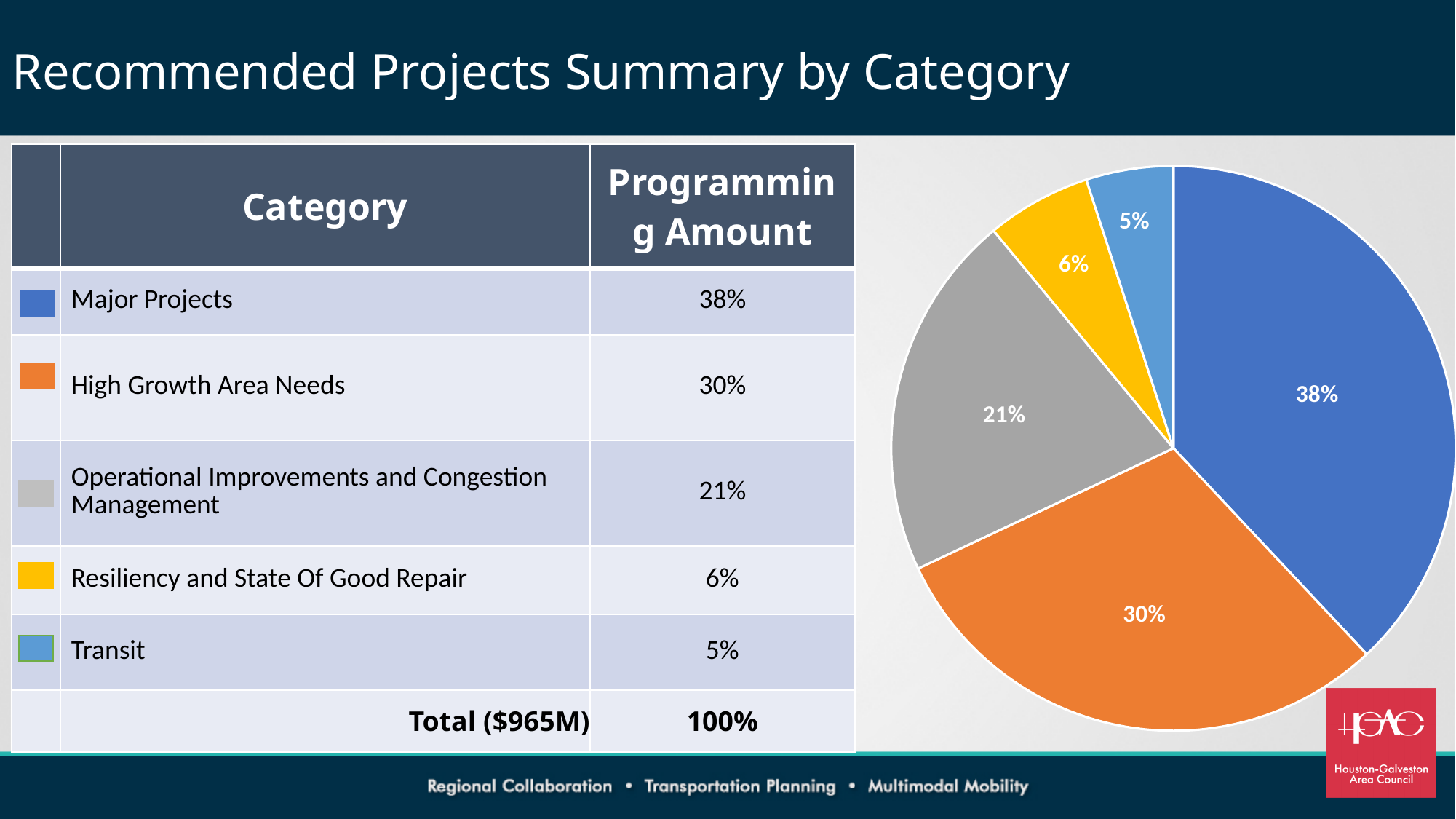
What share of the pie chart does Major Projects represent? 38% What percentage is shown for Resiliency and State Of Good Repair? 6% Which category has the smallest slice of the pie chart? Transit What colour is the slice for High Growth Area Needs? orange What percentage is shown for Operational Improvements and Congestion Management? 21% Which is larger, the share for Operational Improvements and Congestion Management or the share for Resiliency and State Of Good Repair? Operational Improvements and Congestion Management What share of the pie does Transit represent? 5% What is the programming amount share for High Growth Area Needs? 30% What is the difference in percentage points between Major Projects and High Growth Area Needs? 8 What type of chart is shown on the slide? pie chart Which category has the largest slice of the pie chart? Major Projects How many slices does the pie chart have? 5